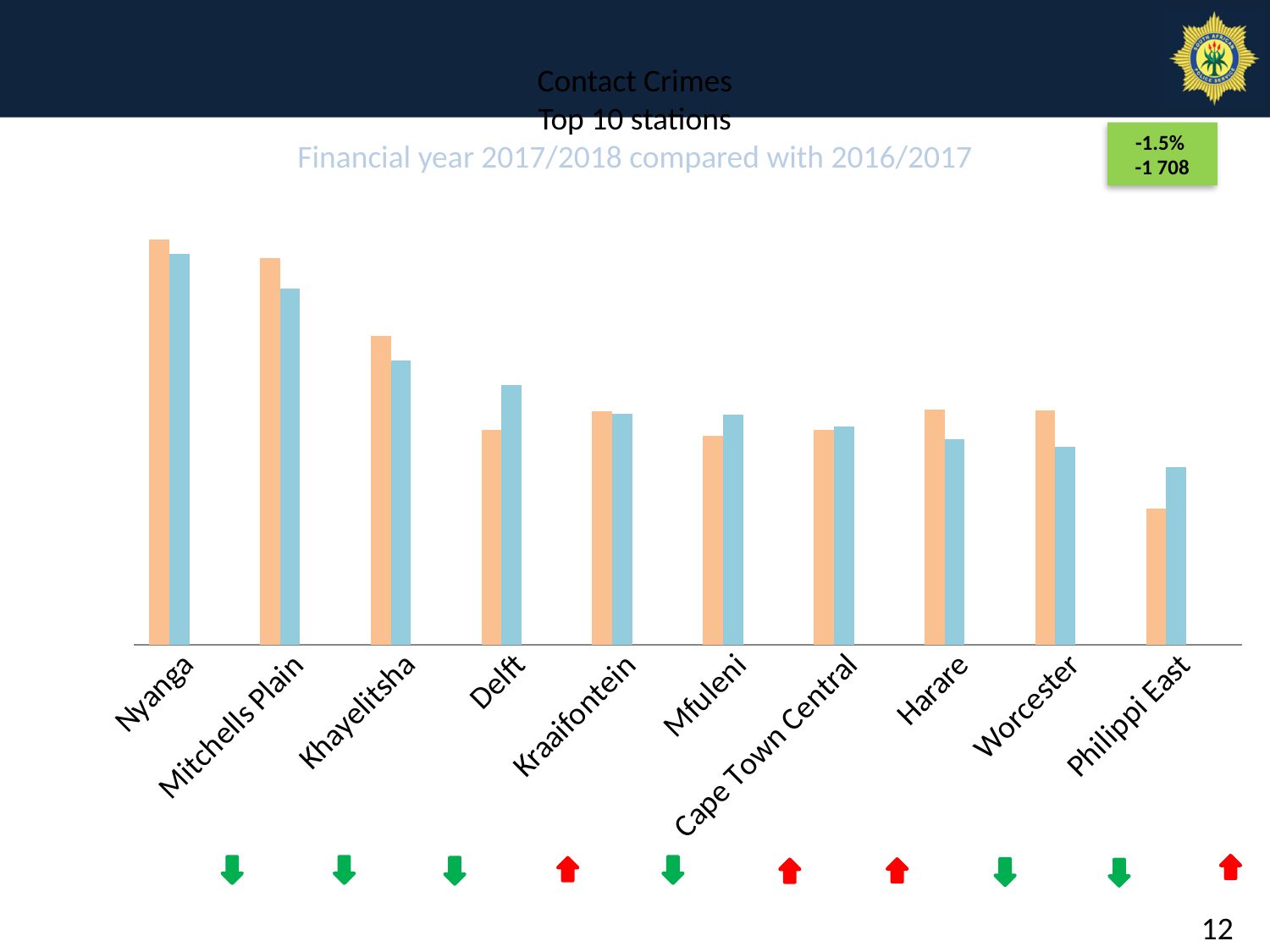
Which station has the taller orange bar, Khayelitsha or Delft? Khayelitsha Which station has the tallest bars in the chart? Nyanga For Mitchells Plain, is the orange bar or the blue bar taller? orange For Delft, is the orange bar or the blue bar taller? blue Do the bar heights generally rise or fall from left to right across the stations? fall Which station has the second-highest bars in the chart? Mitchells Plain How many bars are plotted for each station in the chart? 2 What is the title of the chart? Contact Crimes Top 10 stations Which station has the shortest orange bar in the chart? Philippi East How many stations are shown on the x axis of the chart? 10 What kind of chart is shown on the slide? bar chart